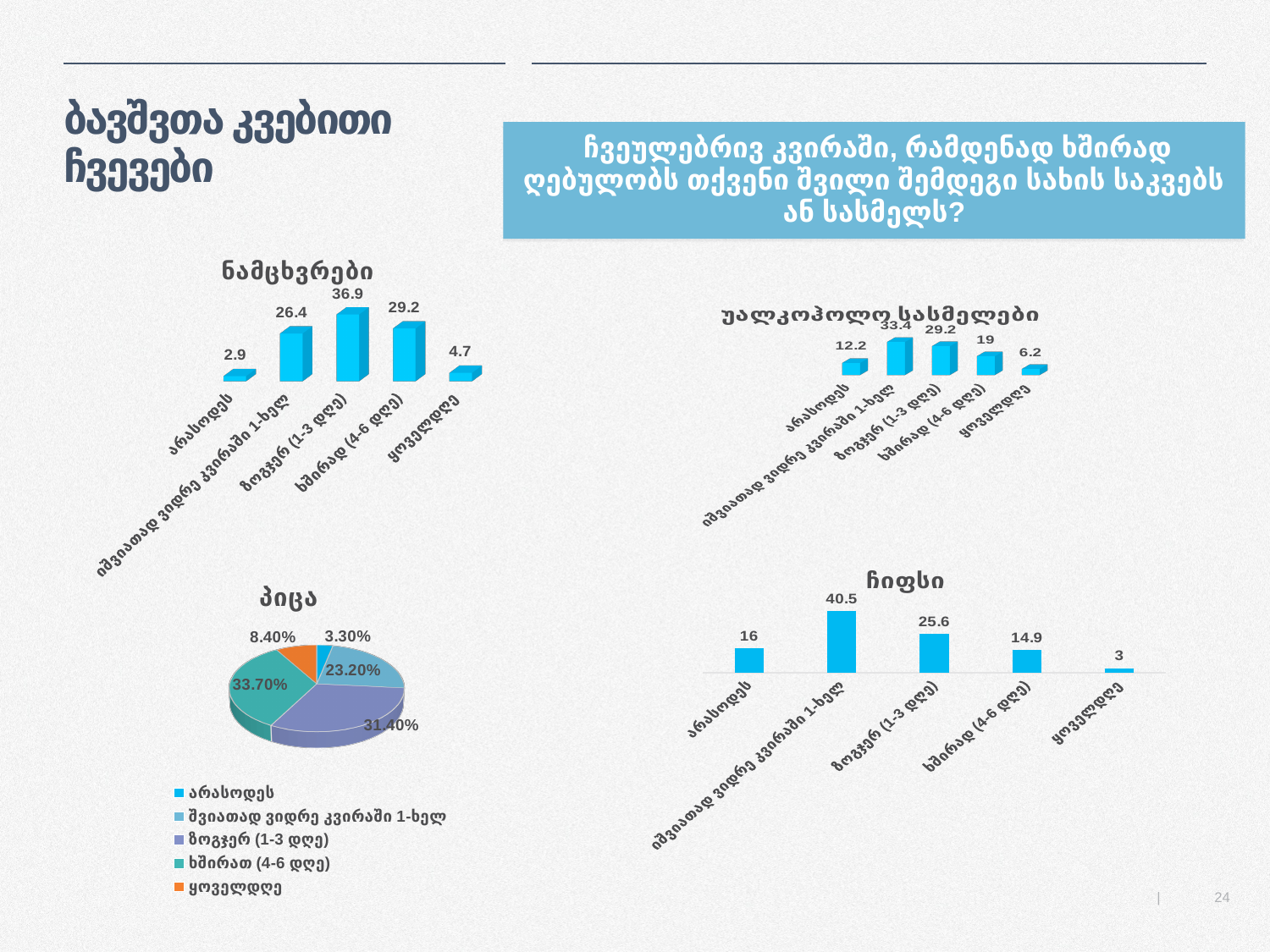
What kind of chart is the პიცა chart? Pie chart In the ჩიფსი chart, what is the value for ყოველდღე? 3 In the უალკოჰოლო სასმელები chart, which category has the highest value? იშვიათად ვიდრე კვირაში 1-ხელ In the ნამცხვრები chart, which category has the lowest value? არასოდეს In the პიცა chart, what share does ხშირად (4-6 დღე) have? 33.70% How many categories does the ჩიფსი chart show? 5 In the პიცა chart, which category has the smallest slice? არასოდეს In the ჩიფსი chart, what is the difference between იშვიათად ვიდრე კვირაში 1-ხელ and ზოგჯერ (1-3 დღე)? 14.9 In the უალკოჰოლო სასმელები chart, which is larger: ზოგჯერ (1-3 დღე) or ხშირად (4-6 დღე)? ზოგჯერ (1-3 დღე) In the უალკოჰოლო სასმელები chart, what is the value for არასოდეს? 12.2 In the ნამცხვრები chart, what is the value for ზოგჯერ (1-3 დღე)? 36.9 In the ნამცხვრები chart, what is the difference between ხშირად (4-6 დღე) and იშვიათად ვიდრე კვირაში 1-ხელ? 2.8